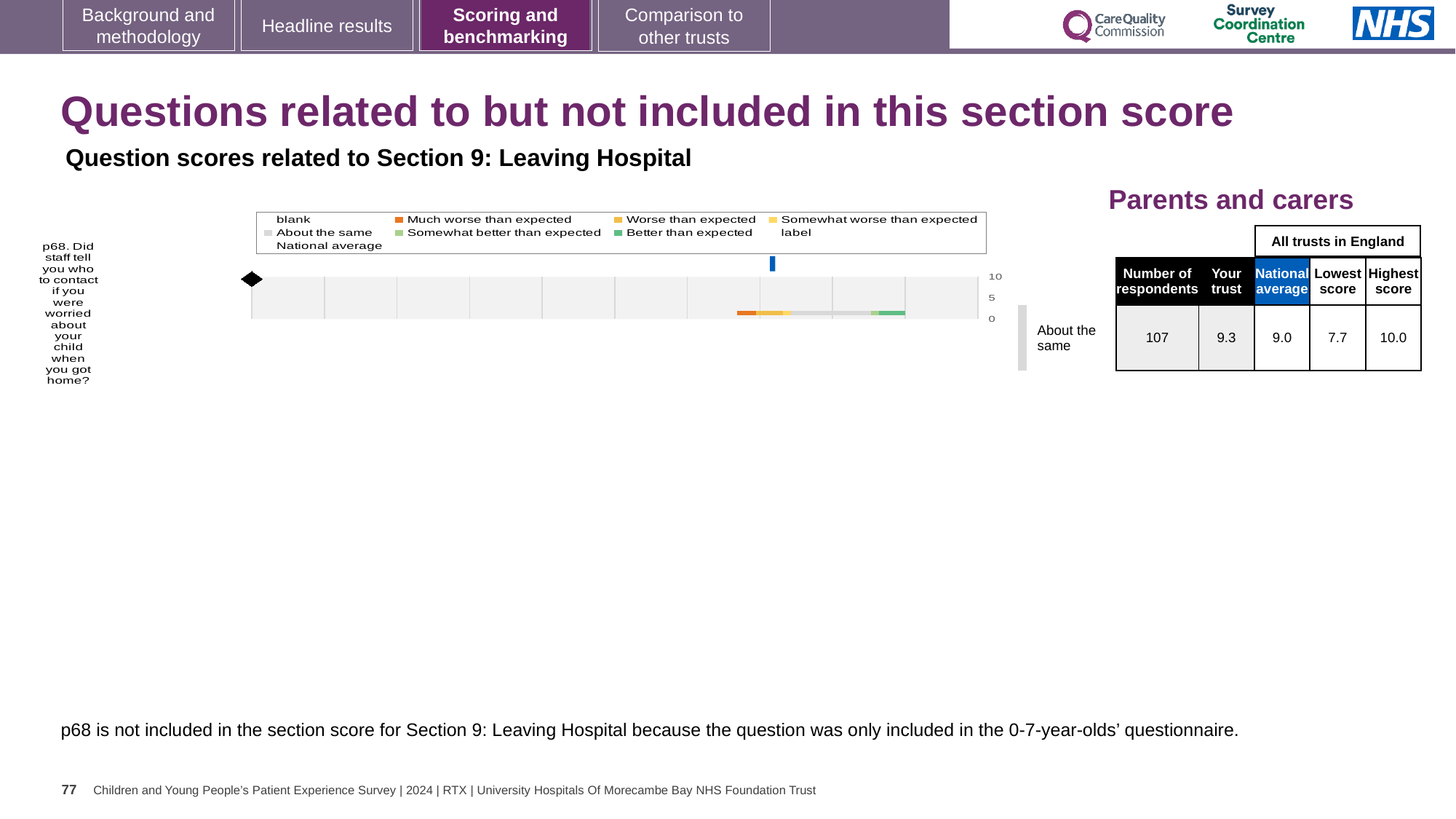
According to the table next to the chart, what is the national average score for p68? 9.0 How many survey questions are plotted in the chart on this slide? 1 According to the table, what is the highest score among all trusts in England for p68? 10.0 What is the difference between the 'Your trust' score and the national average for p68? 0.3 How many respondents answered question p68, according to the table? 107 What benchmark category label is shown to the right of the chart for p68? About the same According to the table, what is the lowest score among all trusts in England for p68? 7.7 What kind of chart is shown for question p68 on this slide? bar chart What is the highest value shown on the chart's score axis? 10 What is the difference between the highest score and the lowest score for p68 in the table? 2.3 Which is larger for p68: the 'Your trust' score or the national average? Your trust According to the table next to the chart, what is the 'Your trust' score for p68? 9.3